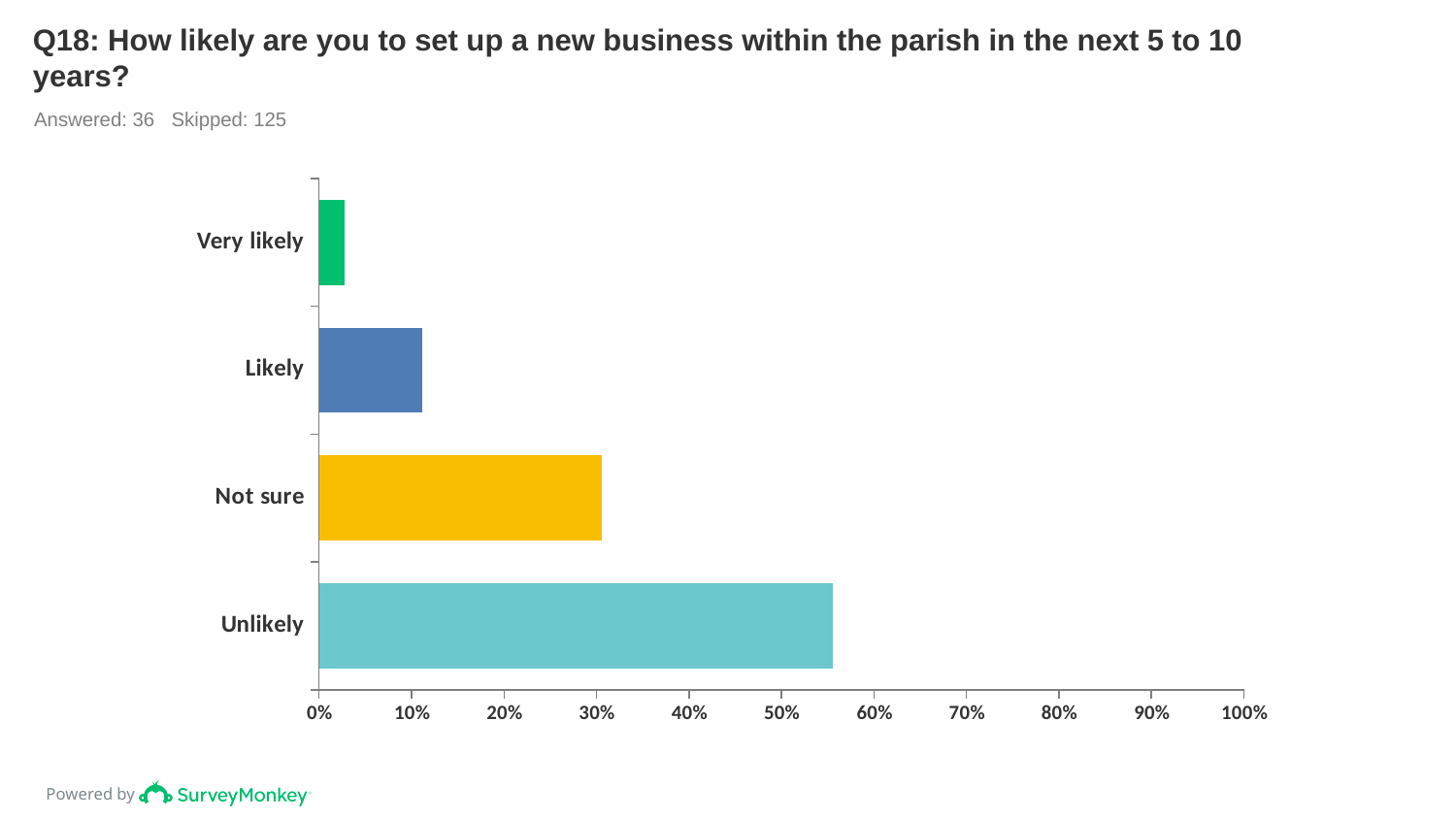
How many categories are shown in the chart? 4 What kind of chart is shown on the slide? bar chart Which is larger, the value for Very likely or the value for Likely? Likely Which category has the highest value? Unlikely Is the value for Unlikely greater or less than 50%? greater How many respondents answered this question according to the slide? 36 Is the value for Very likely greater or less than 10%? less Is the value for Likely greater or less than 20%? less What is the highest value shown on the x axis? 100% Which is larger, the value for Not sure or the value for Likely? Not sure Which category has the lowest value? Very likely